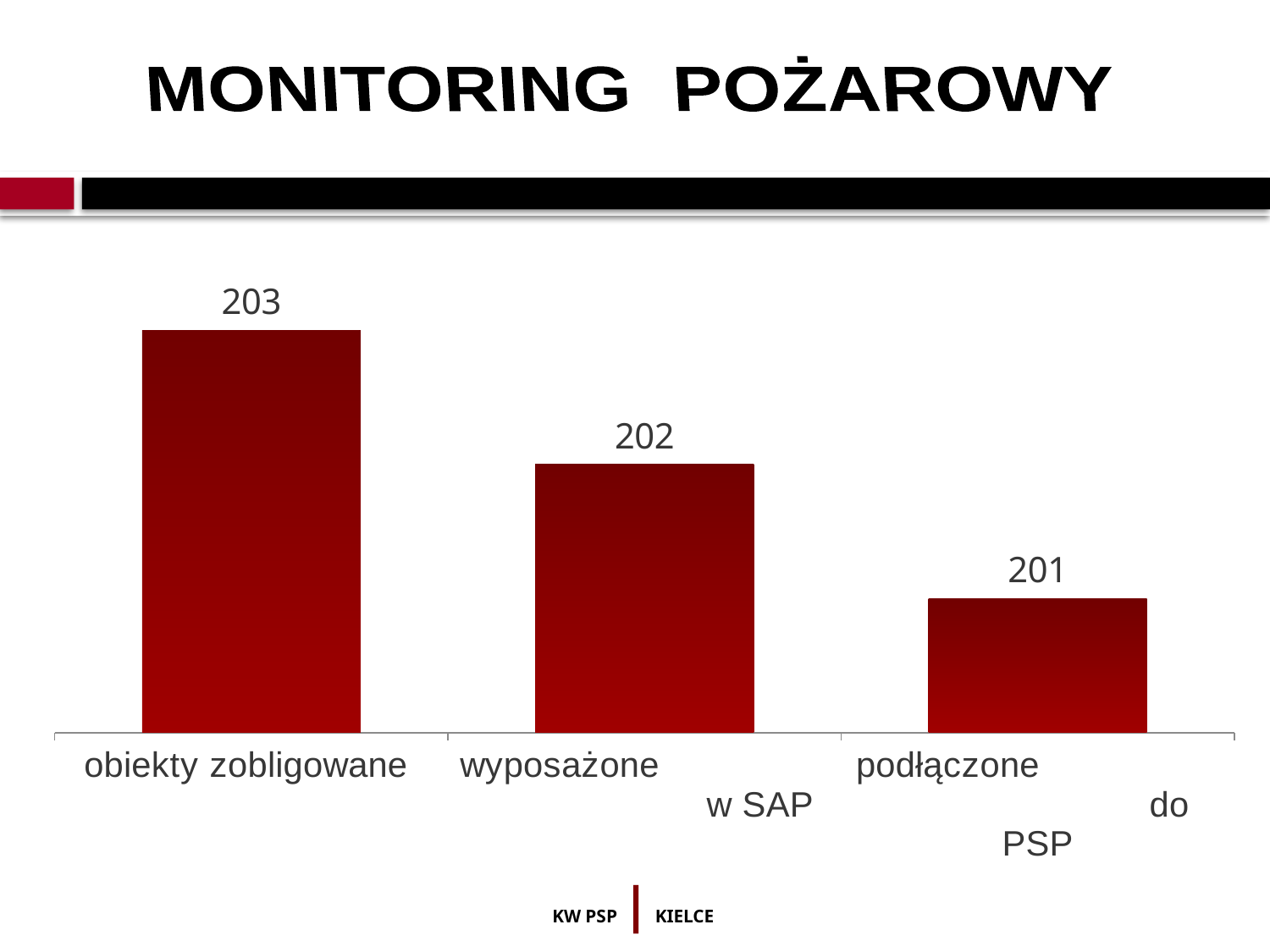
What is the value for "podłączone do PSP"? 201 Which is larger: the value for "obiekty zobligowane" or the value for "wyposażone w SAP"? obiekty zobligowane Do the values rise or fall from left to right across the categories? fall What is the difference between the values for "wyposażone w SAP" and "podłączone do PSP"? 1 Which category has the lowest value? podłączone do PSP What is the value for "wyposażone w SAP"? 202 What is the value for "obiekty zobligowane"? 203 How many categories are shown in the chart? 3 What is the difference between the values for "obiekty zobligowane" and "podłączone do PSP"? 2 Which category has the highest value? obiekty zobligowane What is the title of the slide containing the chart? MONITORING POŻAROWY What kind of chart is shown on the slide? bar chart